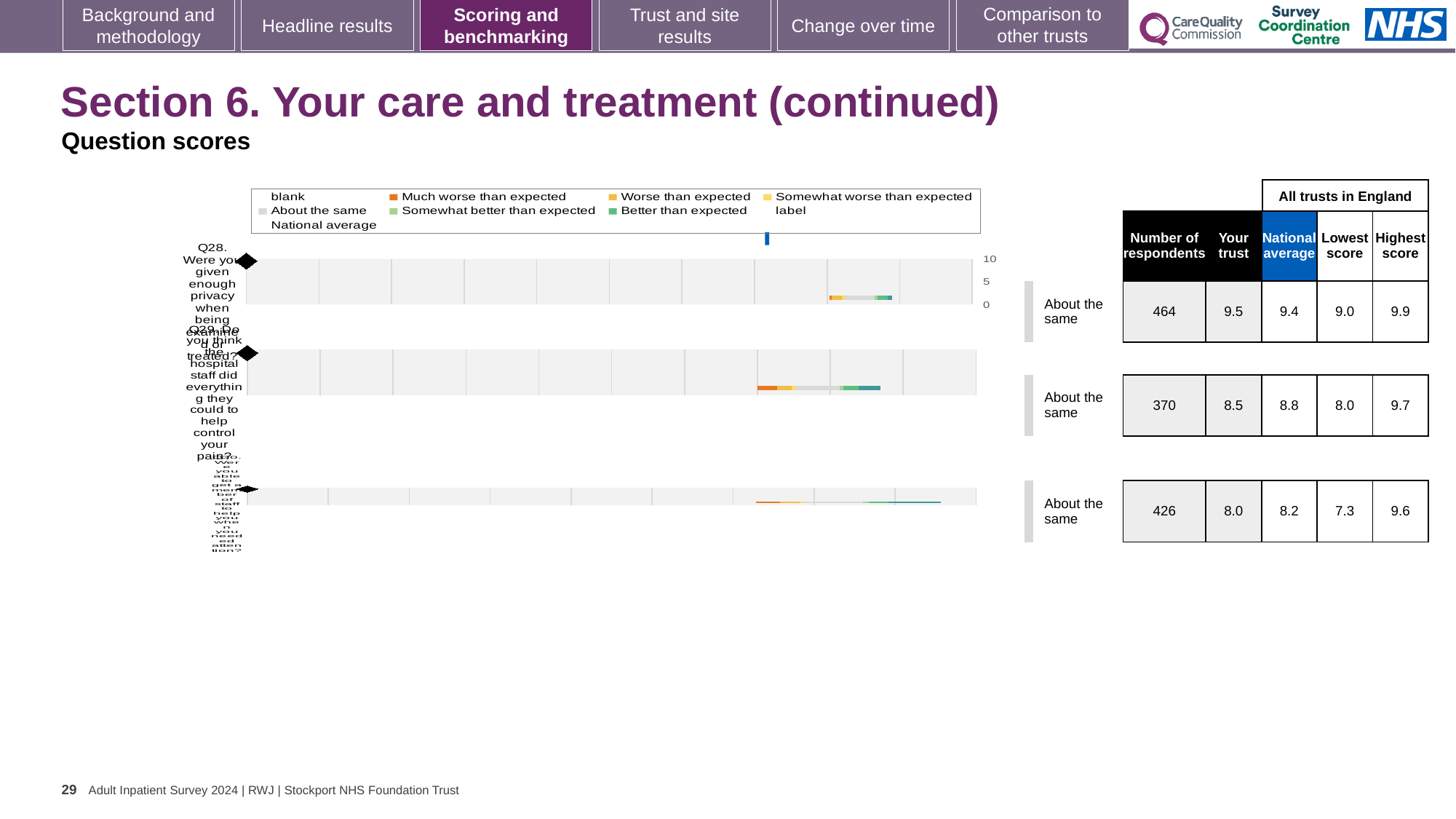
How many respondents answered Q29 (staff did everything to help control pain)? 370 What is the national average score for Q28? 9.4 What benchmark category is shown for Q30? About the same What kind of chart is used to show the question scores? Bar chart What is the highest score across all trusts in England for Q30? 9.6 What is the lowest score across all trusts in England for Q30? 7.3 Which question has the highest 'Your trust' score on this slide? Q28 Which question has the fewest respondents? Q29 For Q28, which is larger: the 'Your trust' score or the national average? Your trust What is the 'Your trust' score for Q28 (privacy when being examined or treated)? 9.5 What is the difference between the national average and the 'Your trust' score for Q29? 0.3 How many questions are plotted on this slide? 3